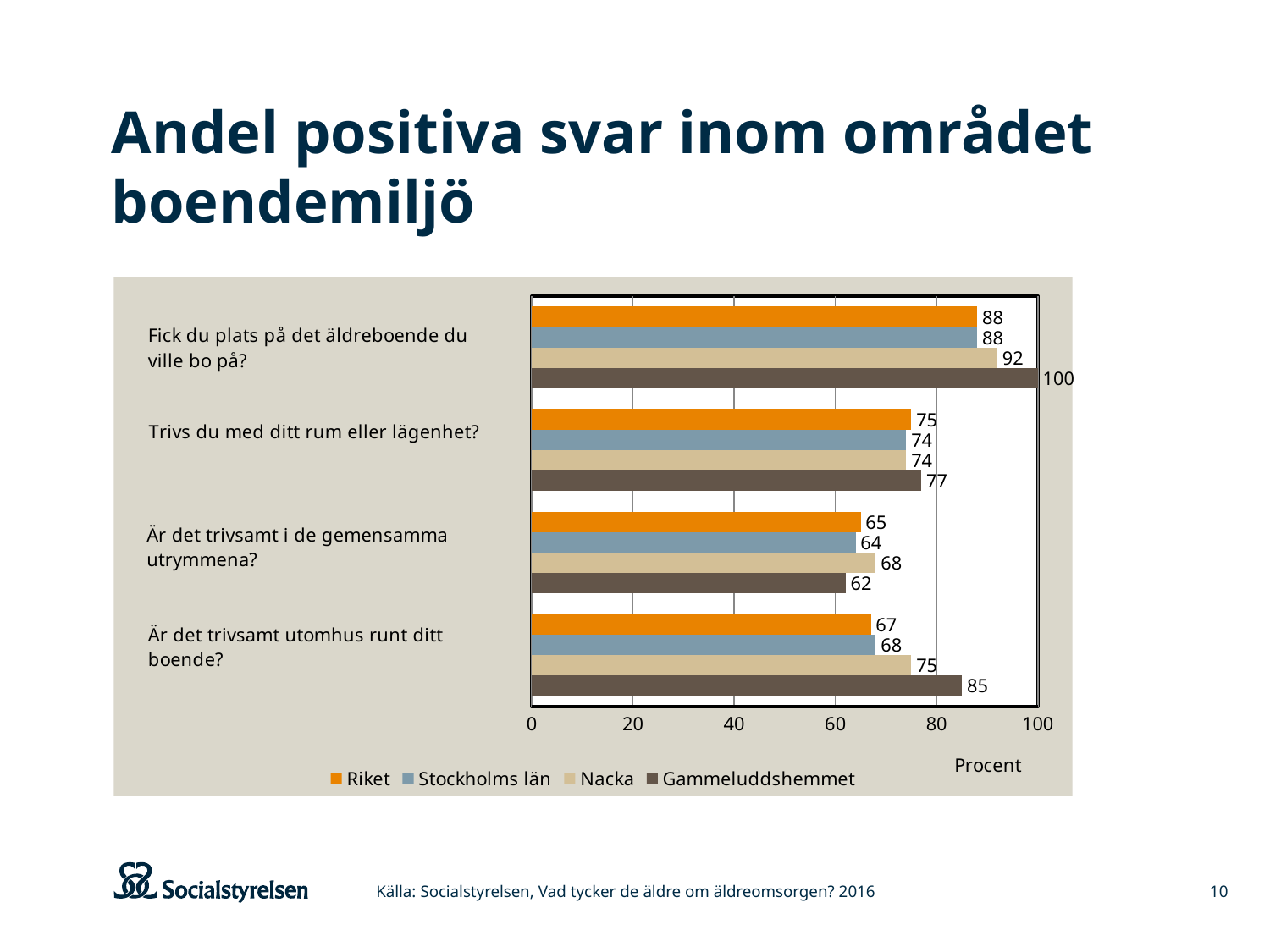
Which series has the highest value on "Är det trivsamt utomhus runt ditt boende?"? Gammeluddshemmet What is the value for Nacka on "Är det trivsamt utomhus runt ditt boende?"? 75 How many questions (categories) are shown on the chart? 4 What is the value for Stockholms län on "Är det trivsamt i de gemensamma utrymmena?"? 64 What is the difference between Gammeluddshemmet and Riket on "Är det trivsamt utomhus runt ditt boende?"? 18 Which is larger on "Trivs du med ditt rum eller lägenhet?": Riket or Gammeluddshemmet? Gammeluddshemmet Is the value for Nacka on "Fick du plats på det äldreboende du ville bo på?" greater or less than 80? greater Which series has the lowest value on "Är det trivsamt i de gemensamma utrymmena?"? Gammeluddshemmet What is the unit label shown on the x axis? Procent What kind of chart is shown on the slide? bar chart What is the value for Gammeluddshemmet on "Fick du plats på det äldreboende du ville bo på?"? 100 How many series does the legend list? 4